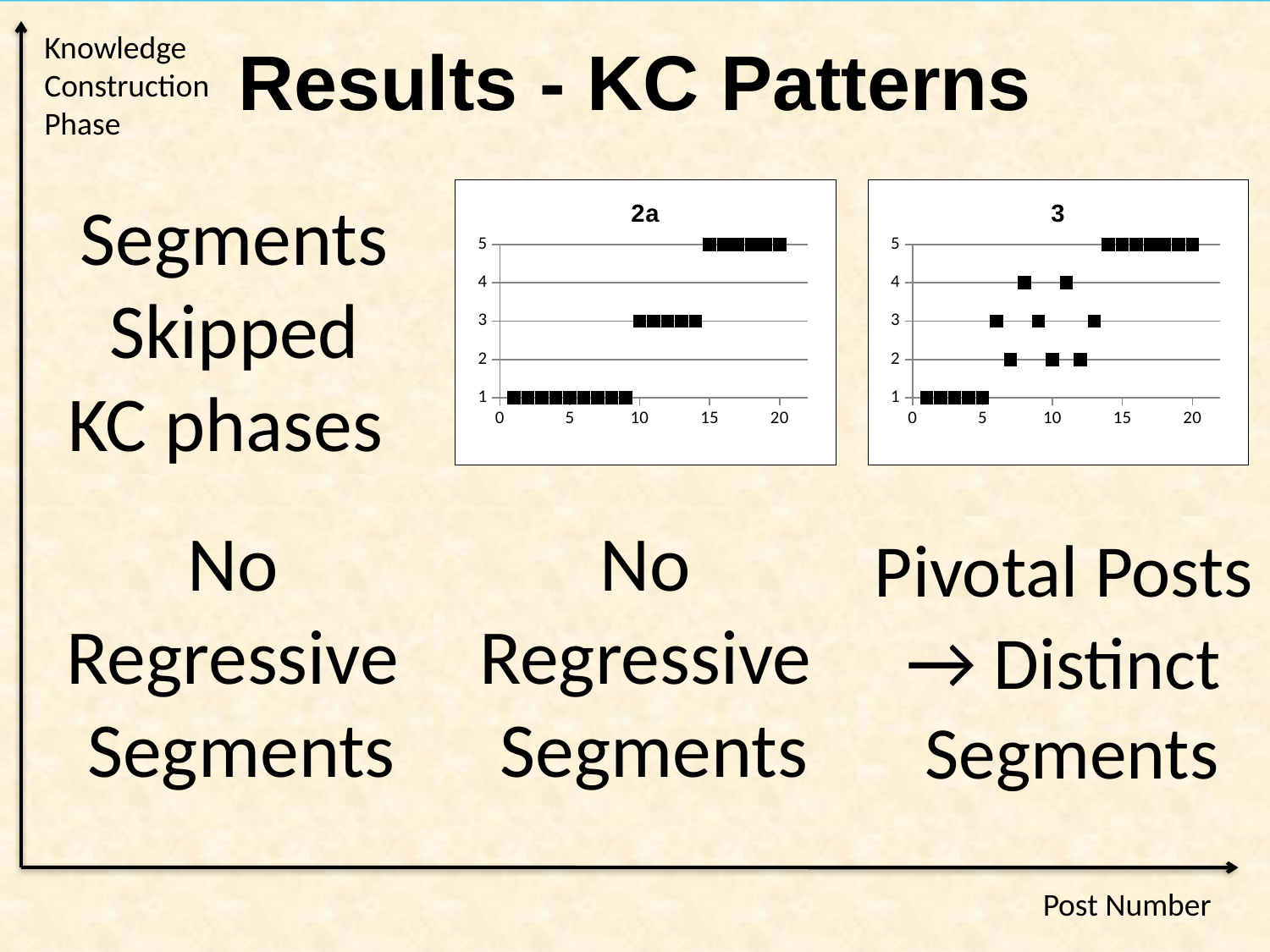
In the chart titled "3", what is the value at post number 15? 5 In the chart titled "2a", what is the value at post number 20? 5 What are the titles of the two charts on the slide? 2a and 3 In the chart titled "3", which is larger, the value at post number 15 or the value at post number 10? post number 15 In the chart titled "3", what is the value at post number 5? 1 In the chart titled "3", what is the value at post number 10? 2 In the chart titled "2a", what is the value at post number 5? 1 In the chart titled "2a", what is the highest value shown on the vertical axis? 5 In the chart titled "2a", do the values rise or fall as the post number increases? rise In the chart titled "2a", which vertical-axis levels have no points plotted on them? 2 and 4 What kind of chart is the chart titled "2a"? scatter chart In the chart titled "2a", what is the value at post number 10? 3